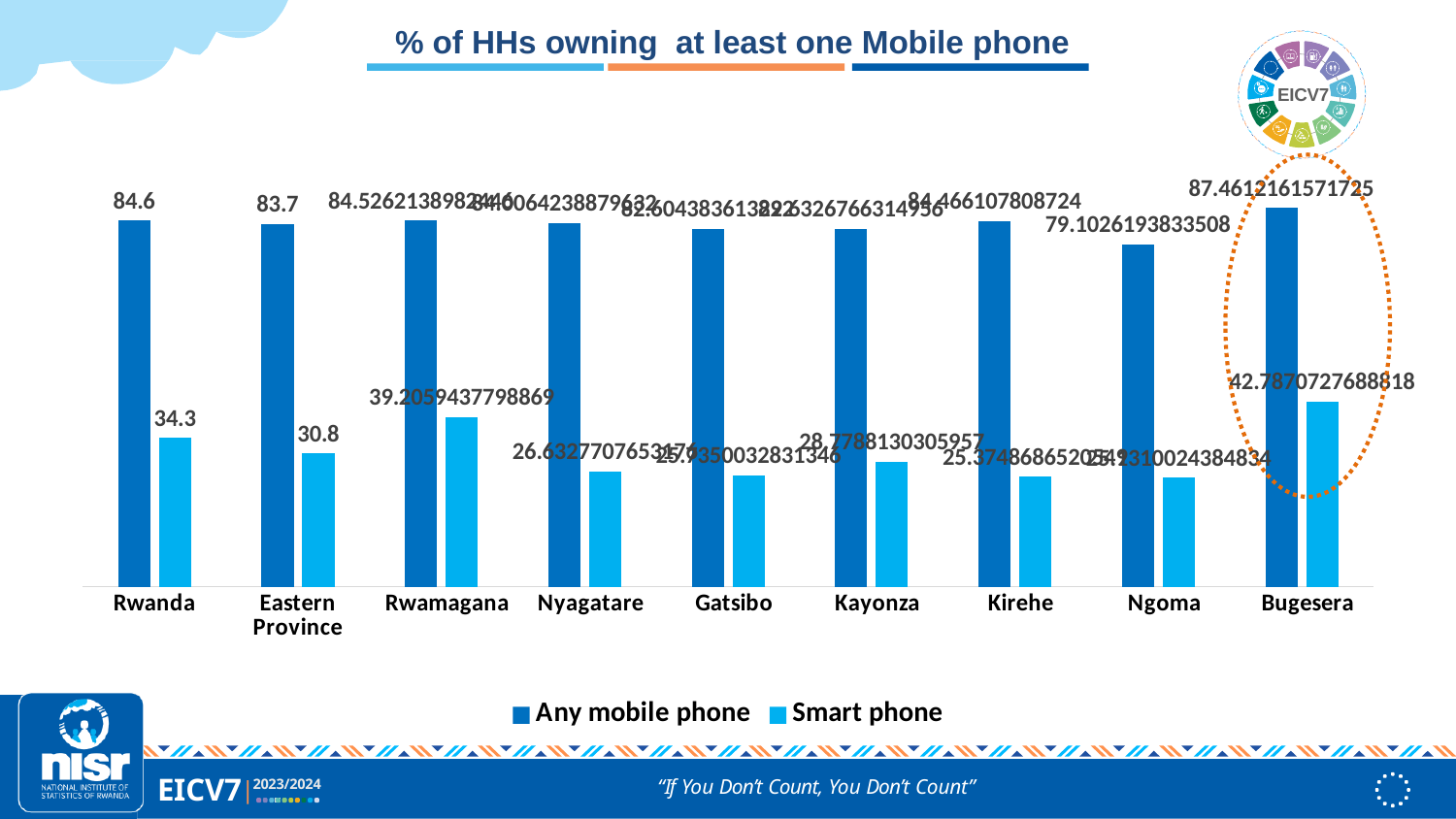
What is the value for Eastern Province in the Smart phone series? 30.8 Which category has the highest value in the Any mobile phone series? Bugesera What is the value for Rwanda in the Smart phone series? 34.3 Which category has the lowest value in the Any mobile phone series? Ngoma What is the value for Rwanda in the Any mobile phone series? 84.6 How many categories are shown on the x axis? 9 What kind of chart is shown on the slide? Bar chart What is the value for Eastern Province in the Any mobile phone series? 83.7 What is the difference between the Any mobile phone and Smart phone values for Rwanda? 50.3 How many series does the legend list? 2 Which has the larger Smart phone value, Rwanda or Eastern Province? Rwanda Which category has the highest value in the Smart phone series? Bugesera